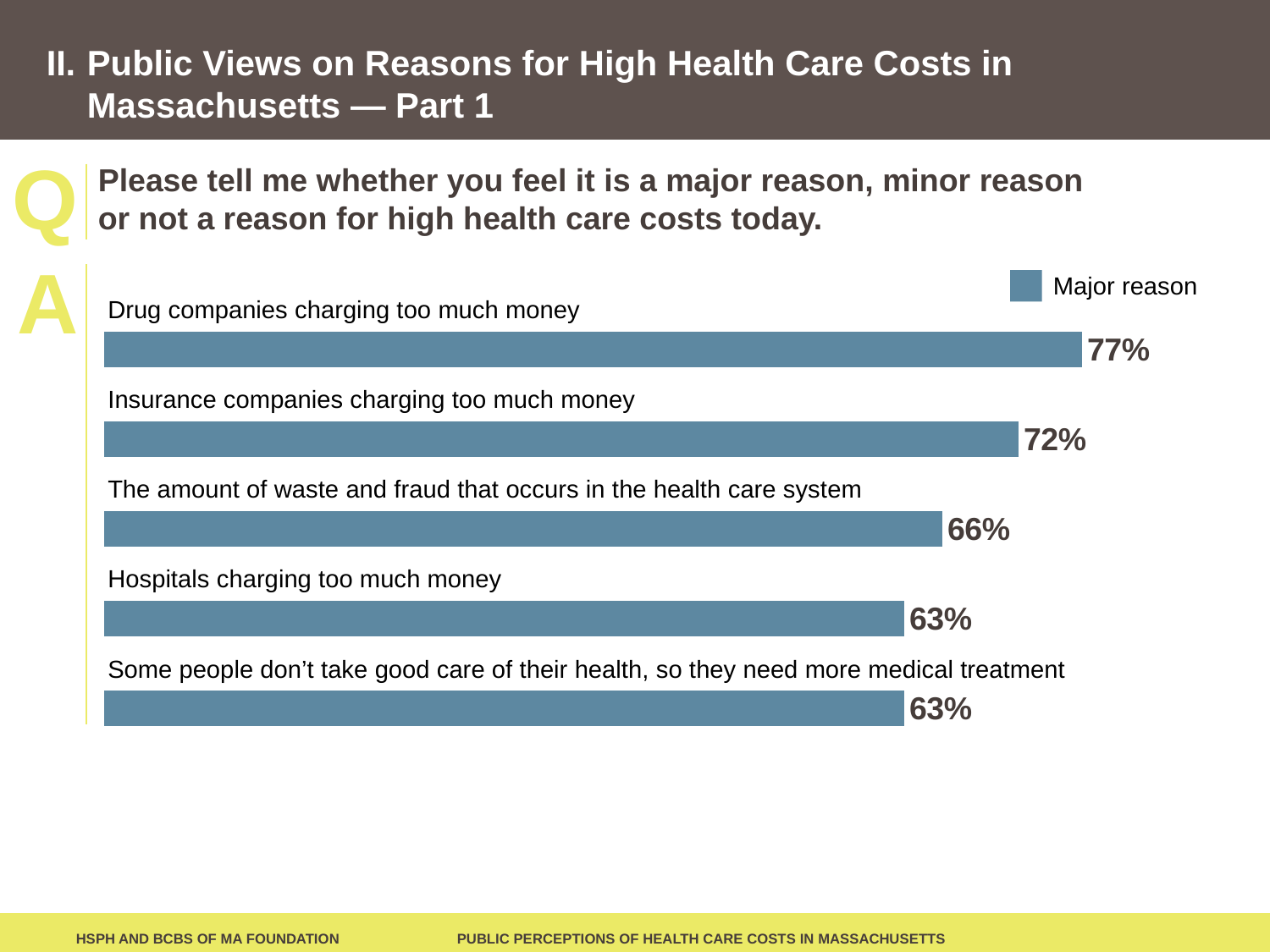
What percentage say insurance companies charging too much money is a major reason? 72% What is the legend entry for the bars? Major reason What kind of chart is shown on the slide? Bar chart How many series does the legend list? 1 How many reasons are shown in the chart? 5 Which is larger: the share for waste and fraud in the health care system or the share for hospitals charging too much money? Waste and fraud in the health care system What is the difference in percentage points between insurance companies charging too much money and hospitals charging too much money? 9 What percentage say the amount of waste and fraud in the health care system is a major reason? 66% Which reason has the highest share saying it is a major reason? Drug companies charging too much money What percentage say hospitals charging too much money is a major reason? 63% What is the difference in percentage points between drug companies charging too much money and insurance companies charging too much money? 5 What percentage say drug companies charging too much money is a major reason for high health care costs? 77%